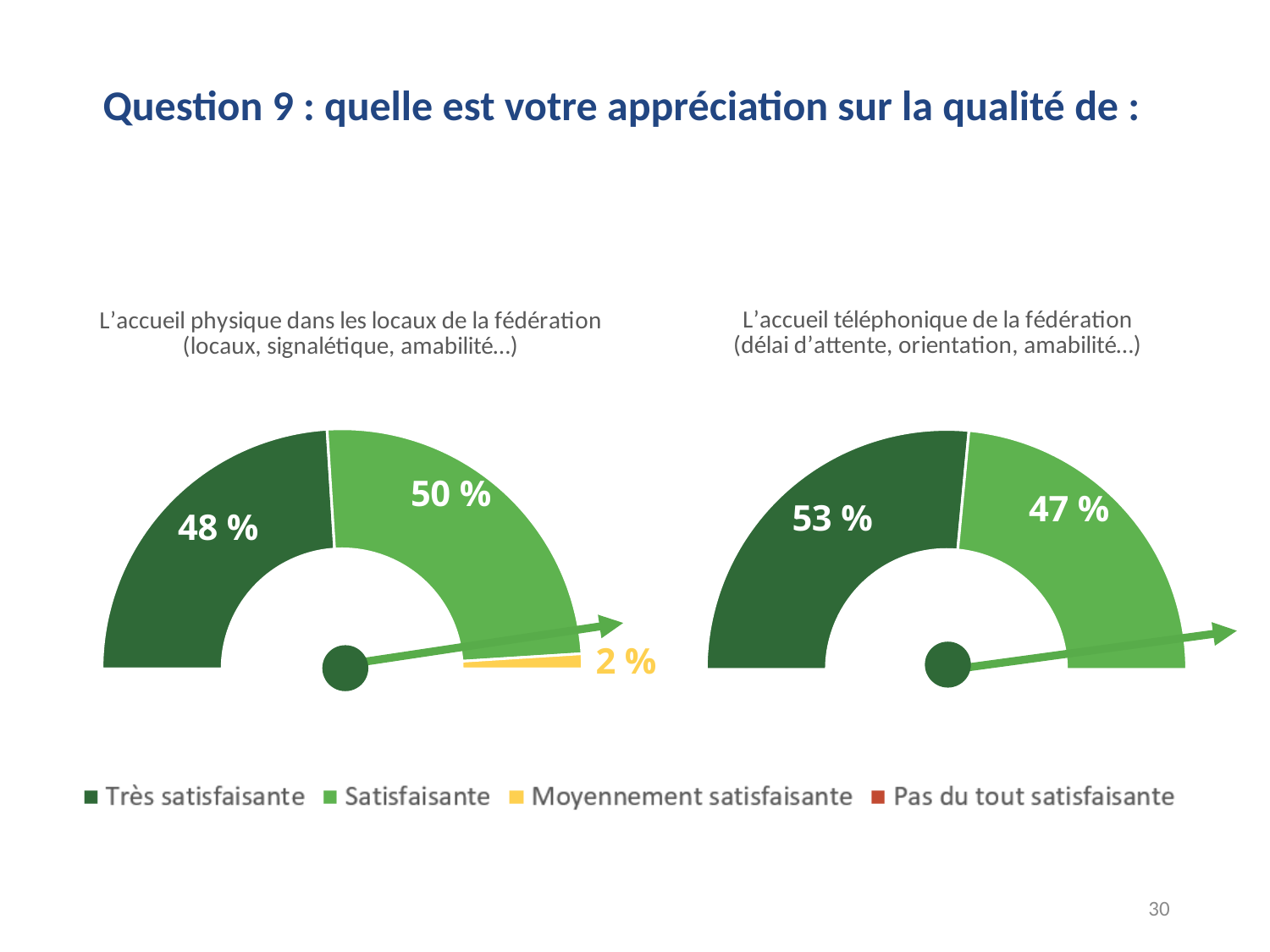
In the chart for 'L'accueil physique dans les locaux de la fédération', which response category has the smallest share? Moyennement satisfaisante How many categories does the legend list? 4 Which chart has the higher share of 'Très satisfaisante': 'L'accueil physique' or 'L'accueil téléphonique'? L'accueil téléphonique What kind of chart is used on this slide? Gauge (half-doughnut) chart In the chart for 'L'accueil téléphonique de la fédération', what percentage answered 'Satisfaisante'? 47 % In the chart for 'L'accueil physique dans les locaux de la fédération', what percentage of respondents answered 'Très satisfaisante'? 48 % In the chart for 'L'accueil téléphonique de la fédération', which response category has the largest share? Très satisfaisante In the chart for 'L'accueil téléphonique de la fédération', what percentage answered 'Très satisfaisante'? 53 % In the chart for 'L'accueil physique dans les locaux de la fédération', what percentage answered 'Moyennement satisfaisante'? 2 % How many response categories are shown with a value in the chart for 'L'accueil physique dans les locaux de la fédération'? 3 In the chart for 'L'accueil physique dans les locaux de la fédération', what percentage answered 'Satisfaisante'? 50 % In the chart for 'L'accueil téléphonique de la fédération', what is the difference in percentage points between 'Très satisfaisante' and 'Satisfaisante'? 6